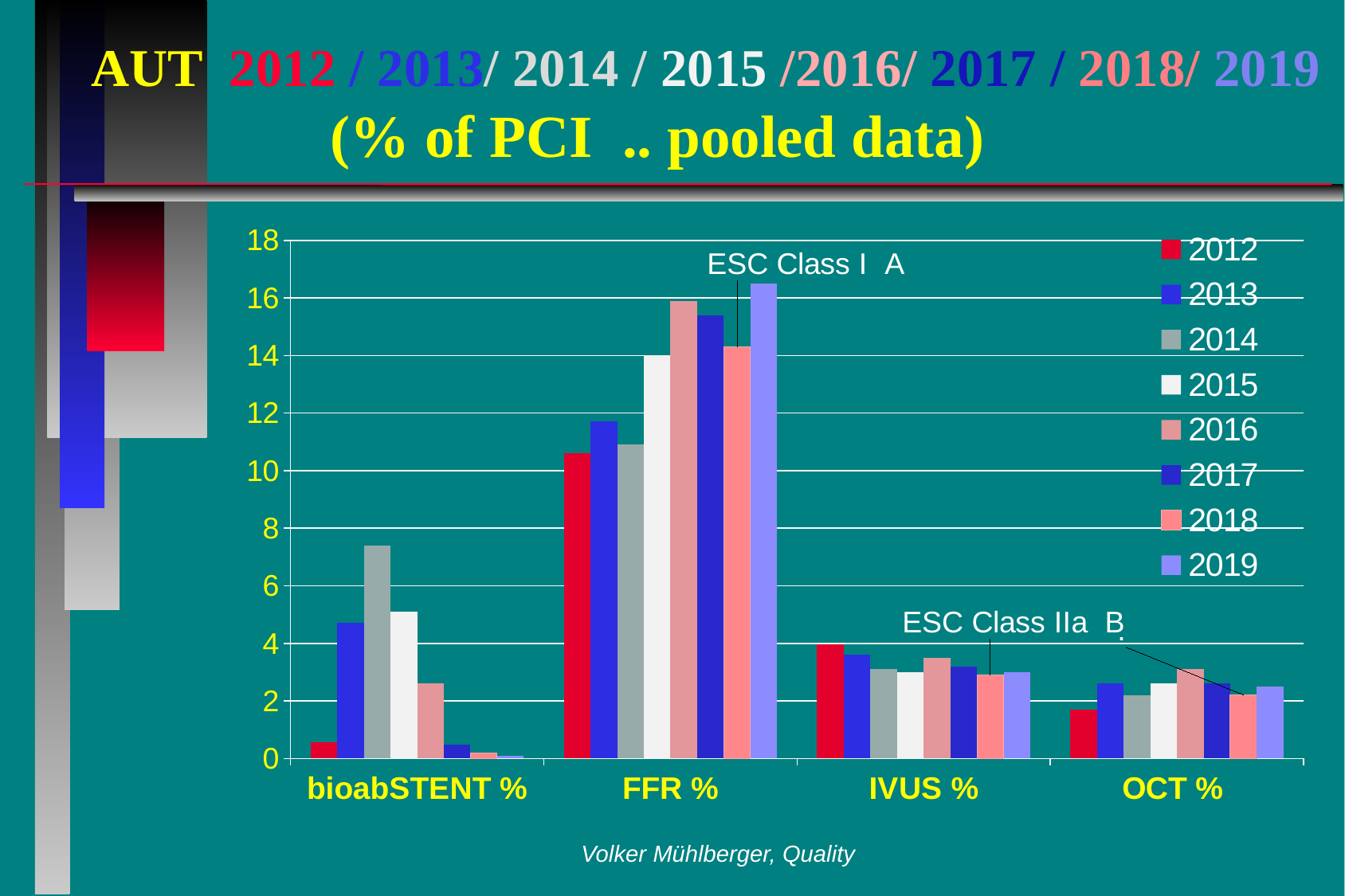
How many categories are shown on the x axis of the chart? 4 What kind of chart is shown on the slide? bar chart In the bioabSTENT % category, which is larger: the 2014 value or the 2016 value? 2014 For the year 2019, which category has the highest value? FFR % Within the FFR % category, which year has the highest bar? 2019 How many series does the legend list? 8 Within the bioabSTENT % category, which year has the highest bar? 2014 Is the value for 2012 in the OCT % category greater or less than 2? less Which annotation is placed above the FFR % bars? ESC Class I A For the year 2012, which is larger: the FFR % value or the IVUS % value? FFR % Is the value for 2016 in the FFR % category greater or less than 14? greater Is the value for 2014 in the bioabSTENT % category greater or less than 6? greater